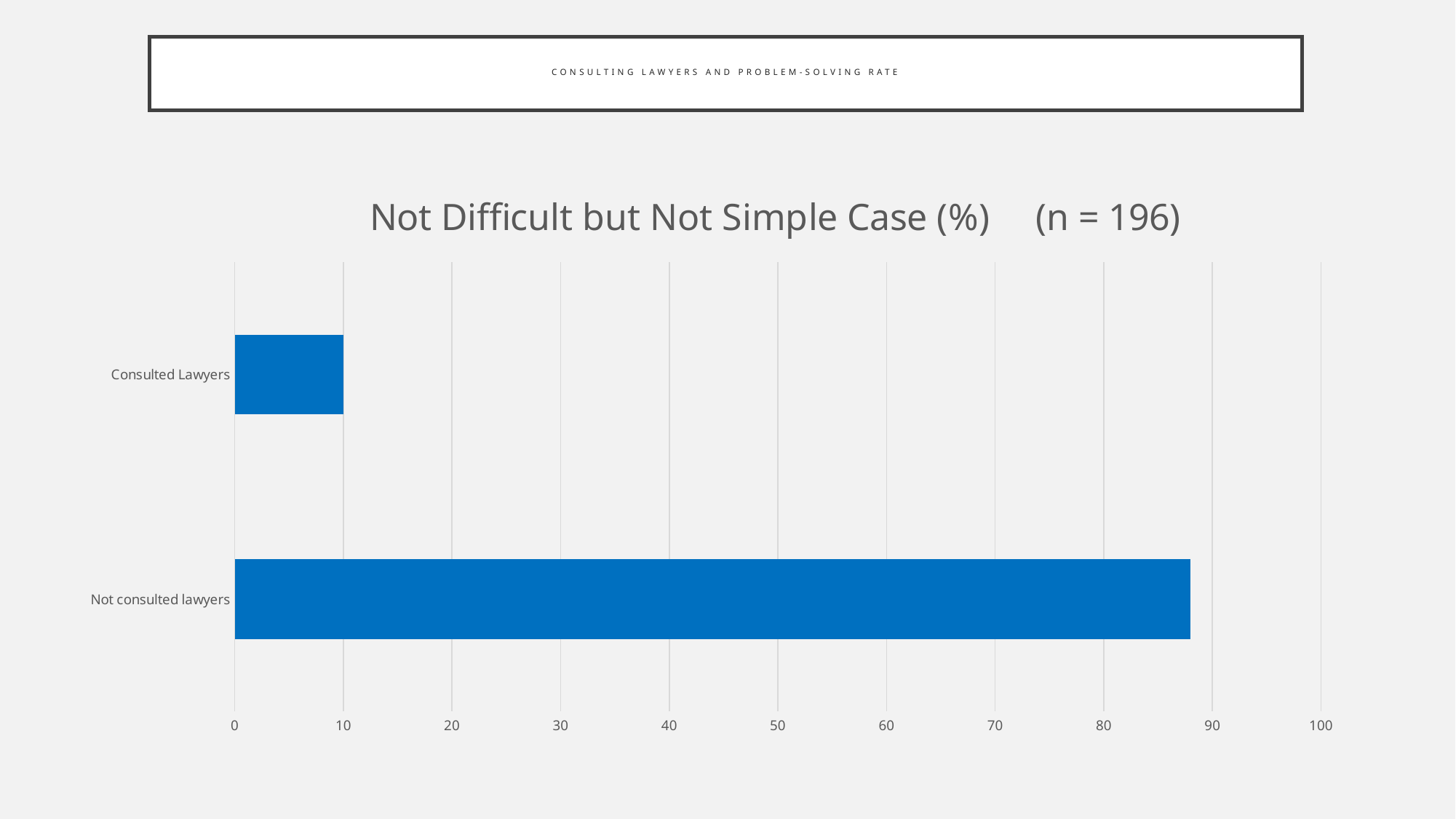
Is the value for Consulted Lawyers greater or less than 20? less How many categories are plotted in the chart? 2 Is the value for Not consulted lawyers greater or less than 90? less What type of chart is shown on the slide? Bar chart What is the value for Consulted Lawyers? 10 Which is larger, the value for Consulted Lawyers or the value for Not consulted lawyers? Not consulted lawyers What is the maximum value shown on the horizontal axis? 100 What is the title of the chart? Not Difficult but Not Simple Case (%) (n = 196) Which category has the highest value? Not consulted lawyers Is the value for Not consulted lawyers greater or less than 80? greater Which category has the lowest value? Consulted Lawyers